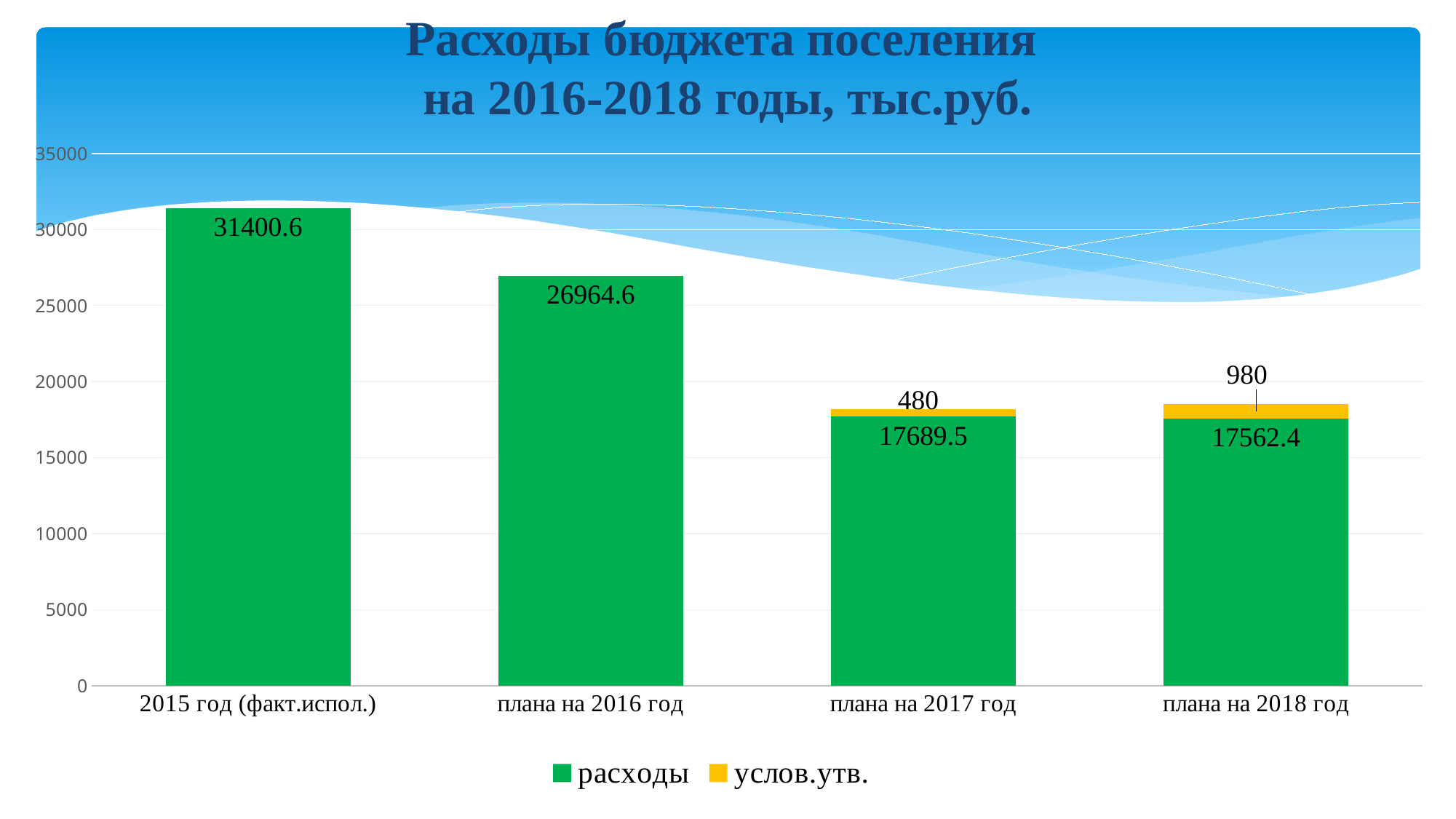
What is the value of расходы for плана на 2016 год? 26964.6 Which category has the highest value of расходы? 2015 год (факт.испол.) What is the difference between расходы for 2015 год (факт.испол.) and плана на 2016 год? 4436 Which category has the lowest value of расходы? плана на 2018 год How many series does the legend list? 2 What is the difference between услов.утв. for плана на 2018 год and плана на 2017 год? 500 How many categories are shown on the x axis? 4 What is the value of услов.утв. for плана на 2018 год? 980 What is the total of the stacked bar for плана на 2017 год? 18169.5 What kind of chart is shown on the slide? Bar chart What is the value of расходы for 2015 год (факт.испол.)? 31400.6 What is the value of услов.утв. for плана на 2017 год? 480